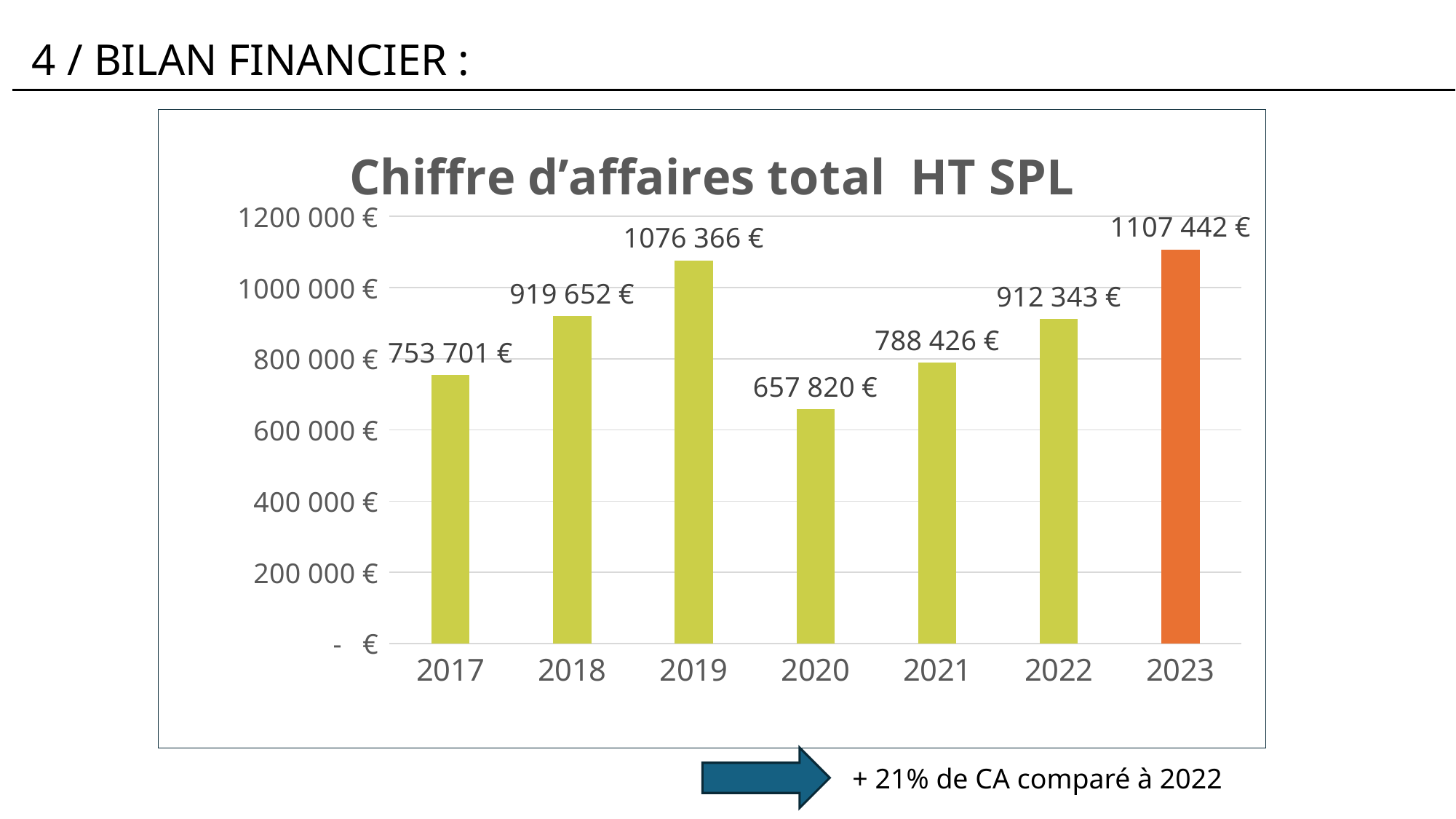
What is the value for 2017 in the chart? 753 701 € What is the value for 2019 in the chart? 1076 366 € Which year has the lowest chiffre d'affaires? 2020 Which is larger, the value for 2021 or the value for 2019? 2019 What is the value for 2020 in the chart? 657 820 € What is the difference between the values for 2019 and 2020? 418 546 € How many years are shown on the x axis of the chart? 7 What is the title of the chart? Chiffre d'affaires total HT SPL Is the value for 2021 greater or less than 800 000 €? less What is the difference between the values for 2023 and 2022? 195 099 € What kind of chart is shown on the slide? bar chart Which year has the highest chiffre d'affaires? 2023